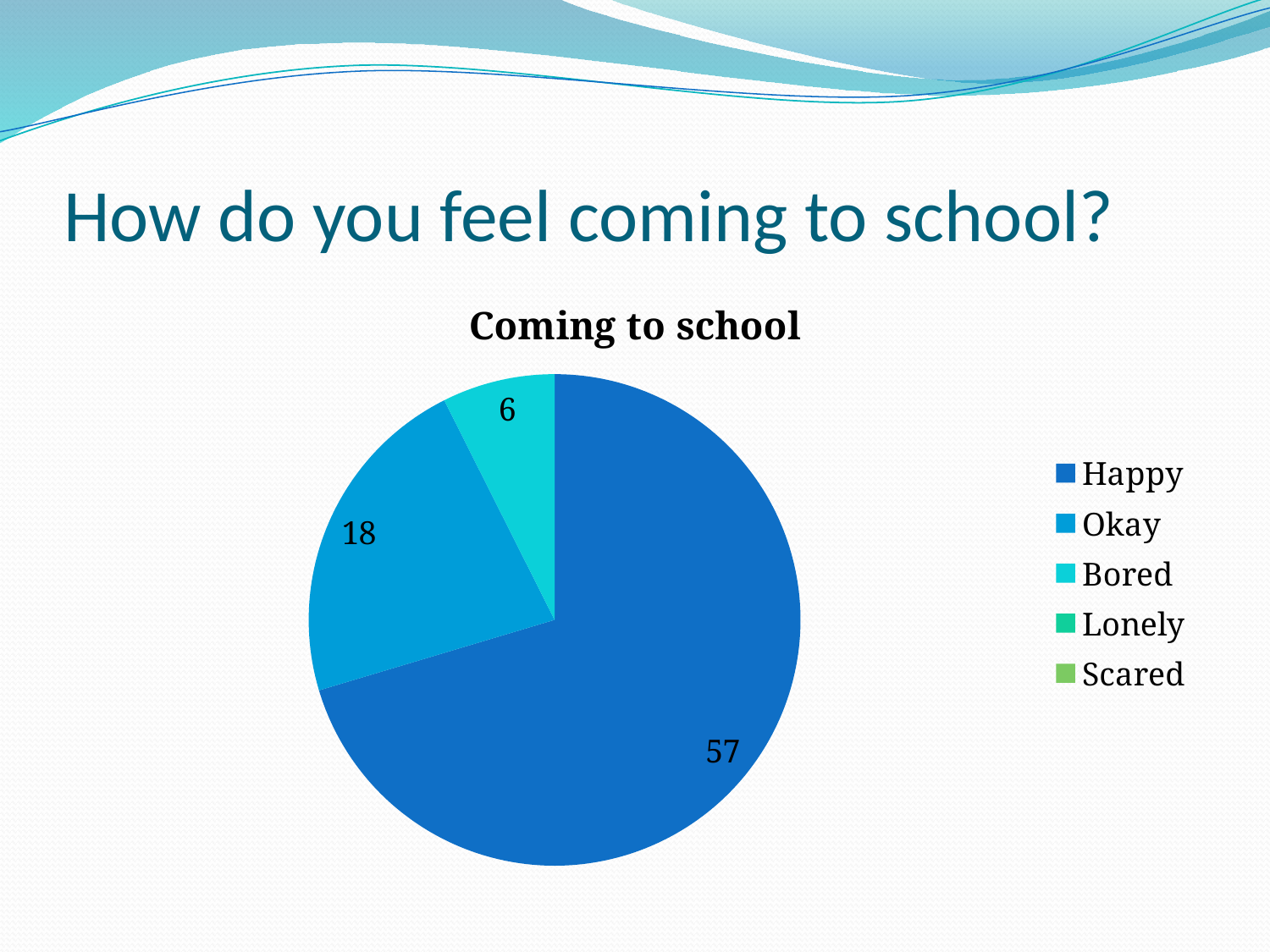
What type of chart is shown on the slide? pie chart Of the slices with printed values, which category has the smallest value? Bored What is the difference between the Happy value and the Okay value? 39 Which category has the largest slice of the pie? Happy Which legend entry is shown in the darkest blue colour? Happy What is the difference between the Okay value and the Bored value? 12 How many categories does the legend list? 5 What value is shown for the Okay slice? 18 Which is larger, the value for Okay or the value for Bored? Okay What value is shown for the Bored slice? 6 What is the title of the chart? Coming to school What value is shown for the Happy slice? 57